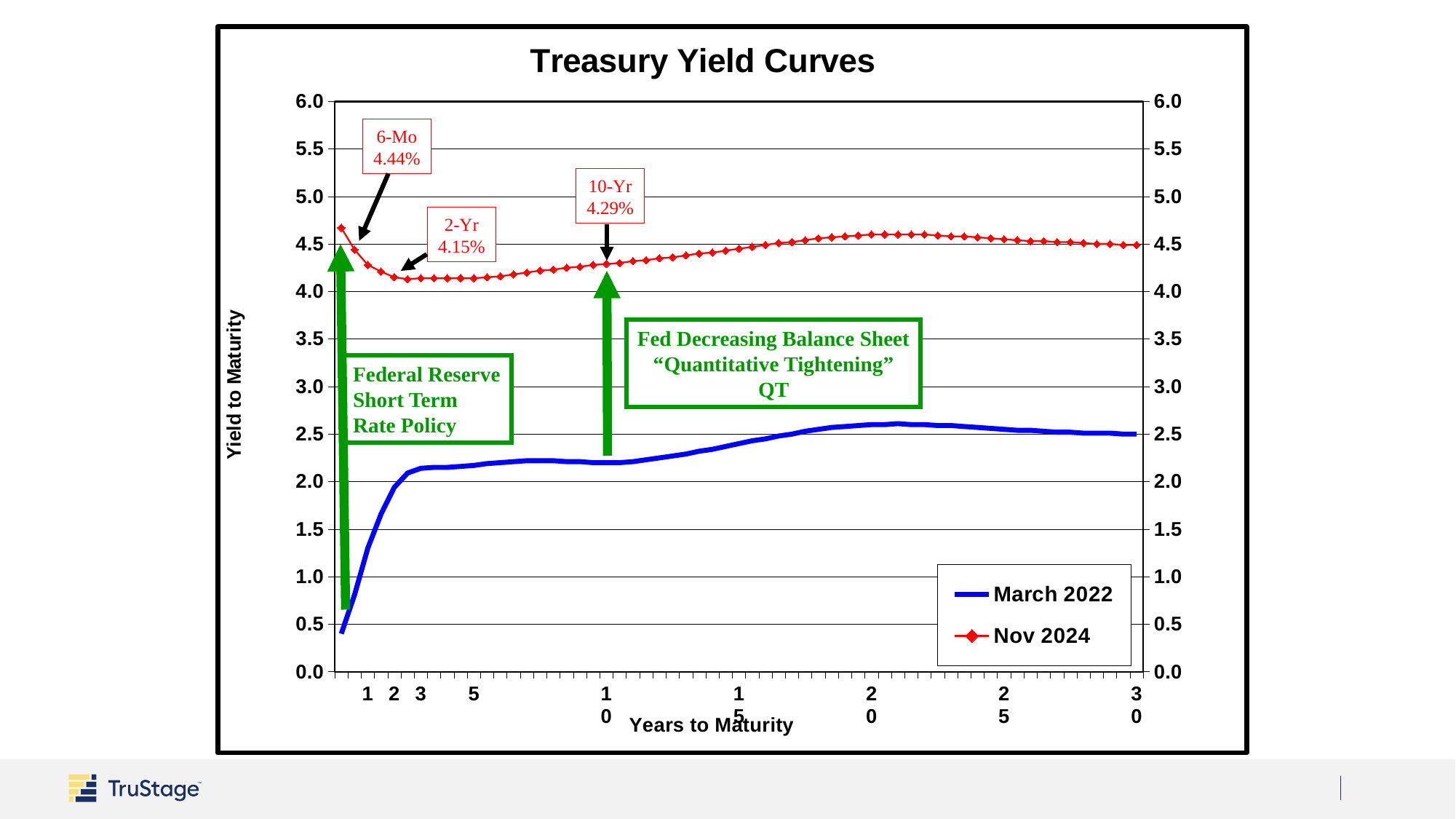
How much higher is the Nov 2024 6-month yield than the Nov 2024 2-year yield? 0.29% What is the Nov 2024 10-year Treasury yield shown on the chart? 4.29% What is the difference between the Nov 2024 10-year yield and the Nov 2024 2-year yield? 0.14% What is the Nov 2024 6-month Treasury yield shown on the chart? 4.44% At 10 years to maturity, which series has the higher yield, March 2022 or Nov 2024? Nov 2024 Is the Nov 2024 yield at 30 years to maturity greater or less than 4.0? greater Of the three labelled Nov 2024 yields (6-Mo, 2-Yr, 10-Yr), which is the lowest? 2-Yr How many series does the legend list? 2 Is the March 2022 yield at 10 years to maturity greater or less than 2.5? less Does the March 2022 yield curve rise or fall between 0 and 5 years to maturity? Rise What kind of chart is shown on the slide? Line chart What is the Nov 2024 2-year Treasury yield shown on the chart? 4.15%